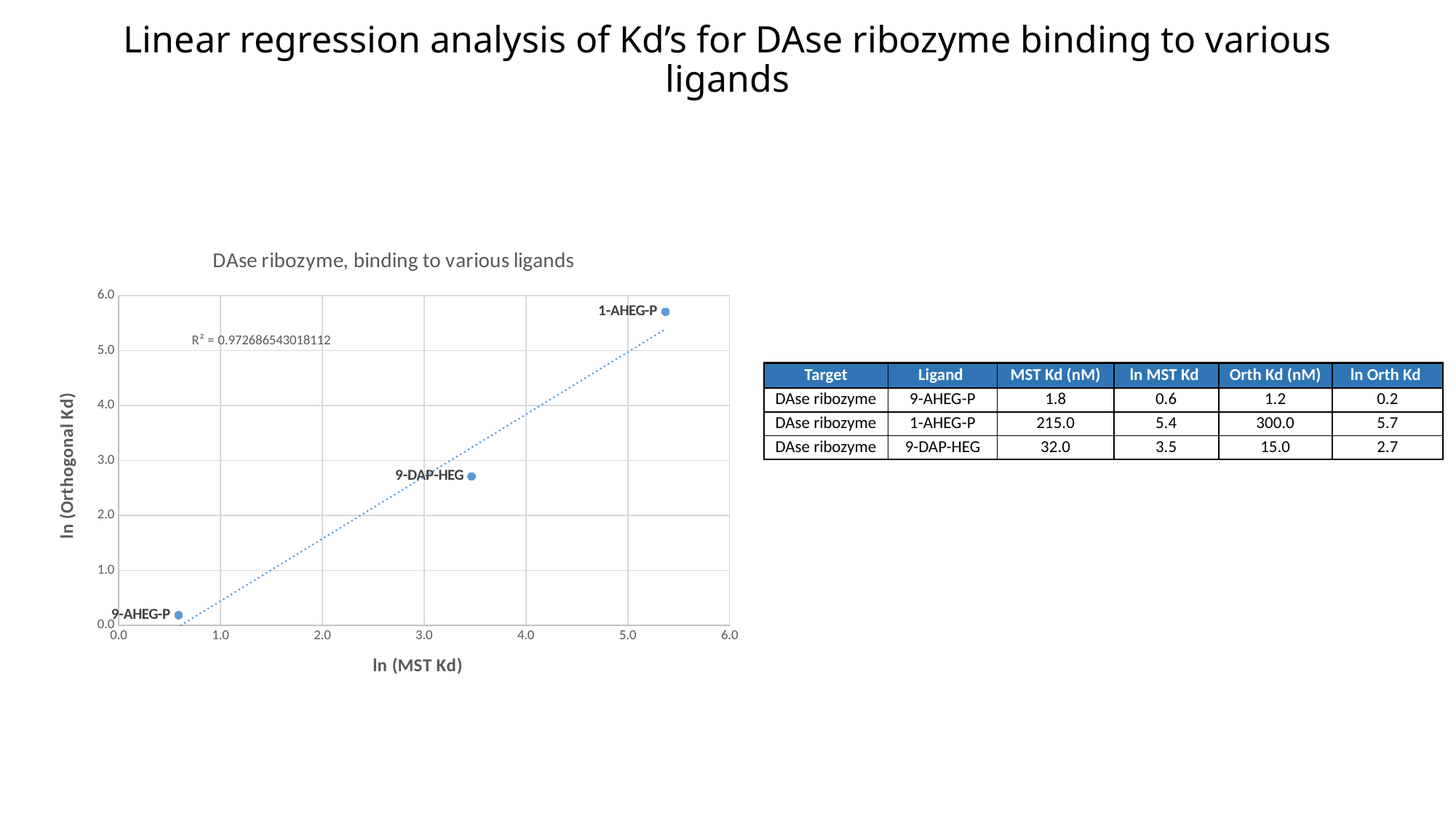
According to the table on the slide, what is the ln Orth Kd value for 1-AHEG-P? 5.7 What R² value is printed on the chart? 0.972686543018112 How many data points are plotted in the chart? 3 Which ligand has the lowest ln (Orthogonal Kd) in the chart? 9-AHEG-P What is the title of the chart's x axis? ln (MST Kd) Is the ln (Orthogonal Kd) value for 9-DAP-HEG greater or less than 2.0? greater What kind of chart is shown on the slide? scatter chart Which ligand has the larger ln (MST Kd), 1-AHEG-P or 9-DAP-HEG? 1-AHEG-P Is the ln (MST Kd) value for 9-AHEG-P greater or less than 1.0? less Do the plotted points rise or fall as ln (MST Kd) increases along the x axis? rise Is the ln (MST Kd) value for 1-AHEG-P greater or less than 5.0? greater Which ligand has the highest ln (Orthogonal Kd) in the chart? 1-AHEG-P